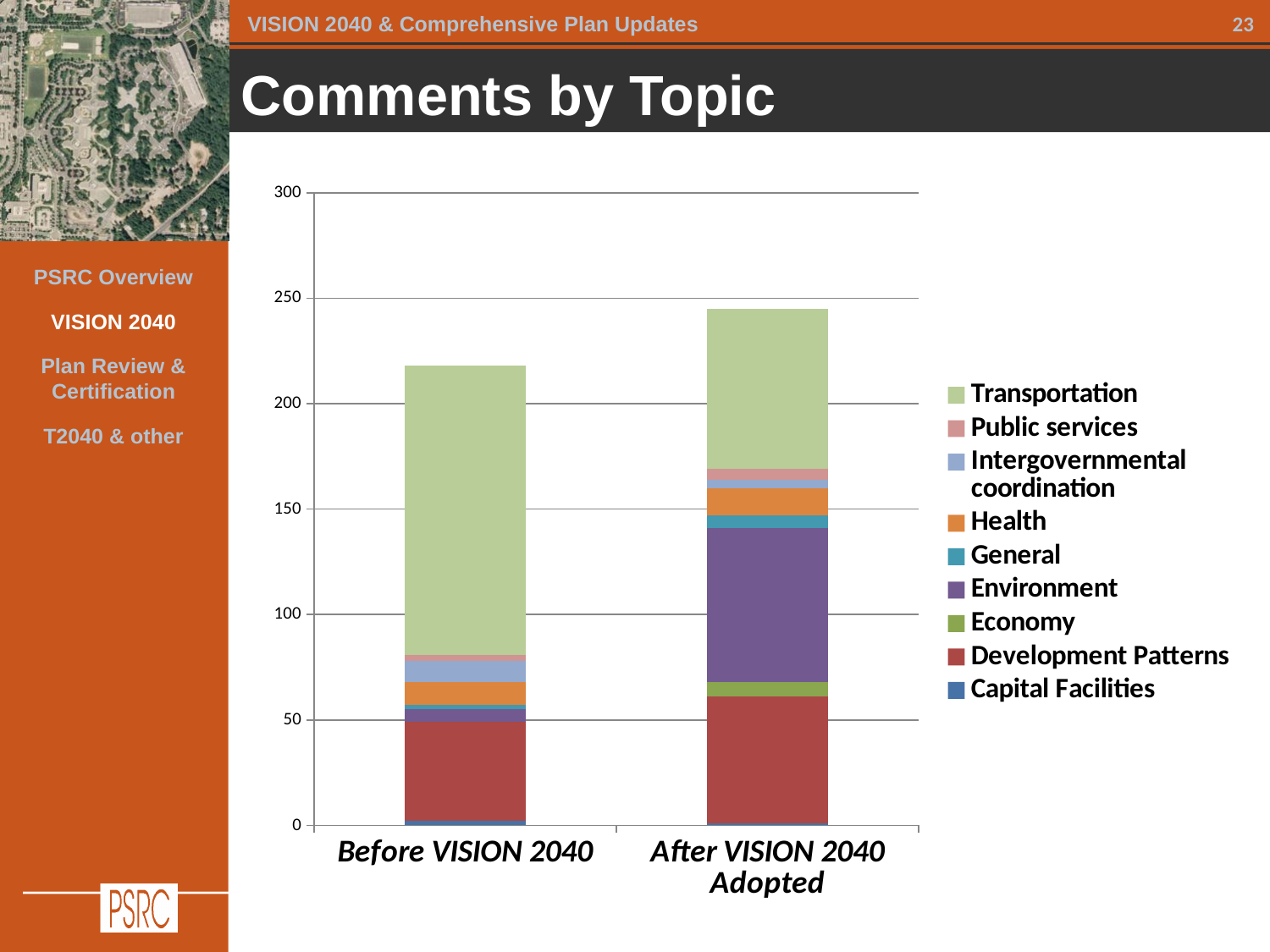
What is the title of the chart on the slide? Comments by Topic Which bar is taller, Before VISION 2040 or After VISION 2040 Adopted? After VISION 2040 Adopted Is the total for the Before VISION 2040 bar greater or less than 200? greater Do the total comments rise or fall from Before VISION 2040 to After VISION 2040 Adopted? rise Which series is listed first in the chart's legend? Transportation How many series does the chart's legend list? 9 Is the total for the Before VISION 2040 bar greater or less than 250? less What kind of chart is shown on the slide? stacked bar chart Which bar has the larger Environment segment, Before VISION 2040 or After VISION 2040 Adopted? After VISION 2040 Adopted Is the total for the After VISION 2040 Adopted bar greater or less than 200? greater How many categories are shown on the x axis of the chart? 2 Which bar has the larger Transportation segment, Before VISION 2040 or After VISION 2040 Adopted? Before VISION 2040